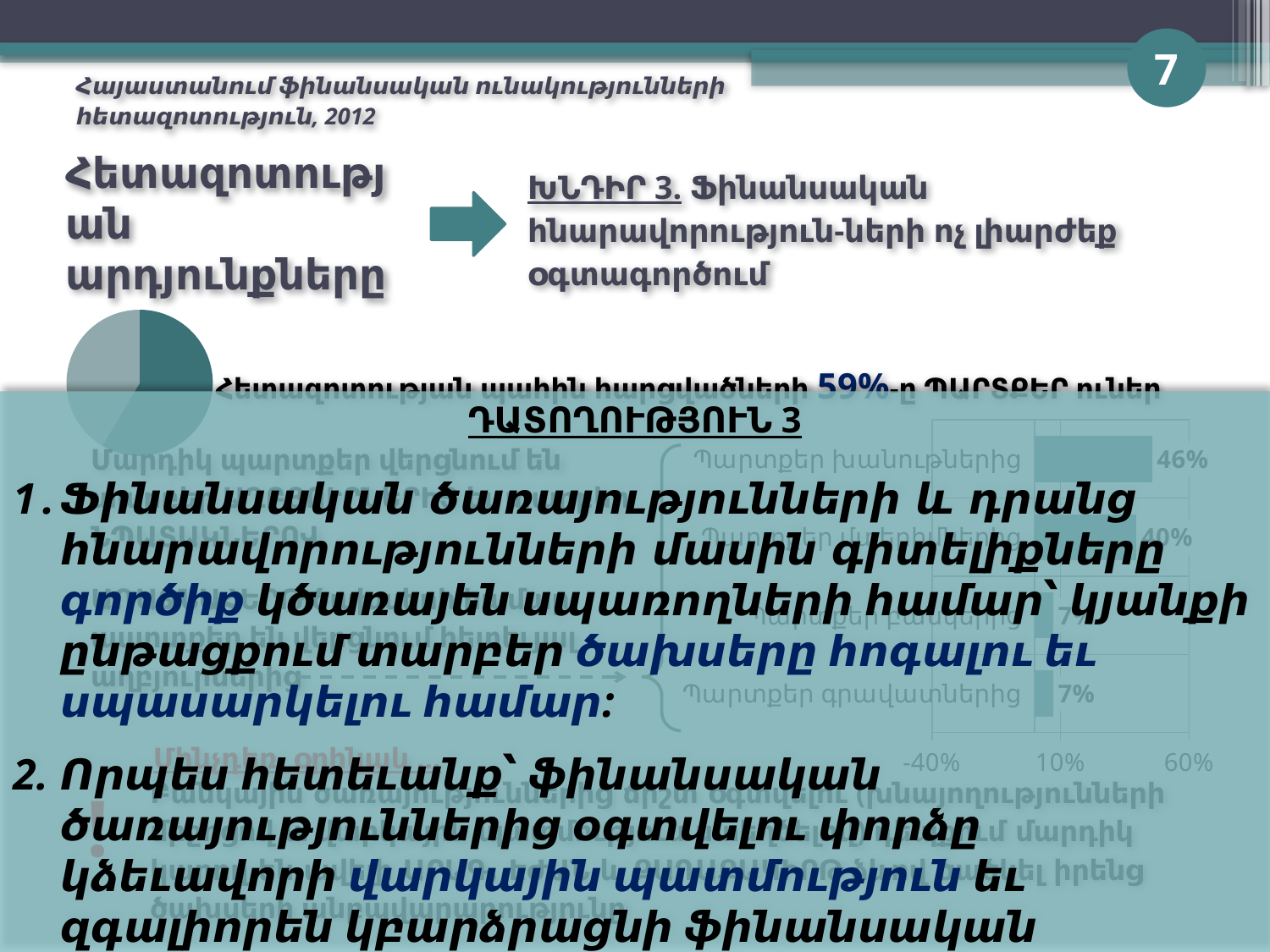
In the bar chart on the right, which is larger: the value for Պարտքեր խանութներից or the value for Պարտքեր մտերիմներից? Պարտքեր խանութներից In the bar chart on the right, which category has the highest value? Պարտքեր խանութներից What kind of chart is shown on the right side of the slide? bar chart In the bar chart on the right, what is the lowest tick label shown on the horizontal axis? -40% In the bar chart on the right, is the value for Պարտքեր խանութներից greater or less than 10%? greater In the bar chart on the right, how many categories are plotted? 4 In the bar chart on the right, is the value for Պարտքեր գրավատներից greater or less than 10%? less In the bar chart on the right, what is the highest tick label shown on the horizontal axis? 60% In the bar chart on the right, what is the value for Պարտքեր խանութներից? 46% In the bar chart on the right, what is the difference between the values for Պարտքեր խանութներից and Պարտքեր գրավատներից? 39% In the bar chart on the right, what is the value for Պարտքեր մտերիմներից? 40% In the bar chart on the right, what is the value for Պարտքեր գրավատներից? 7%